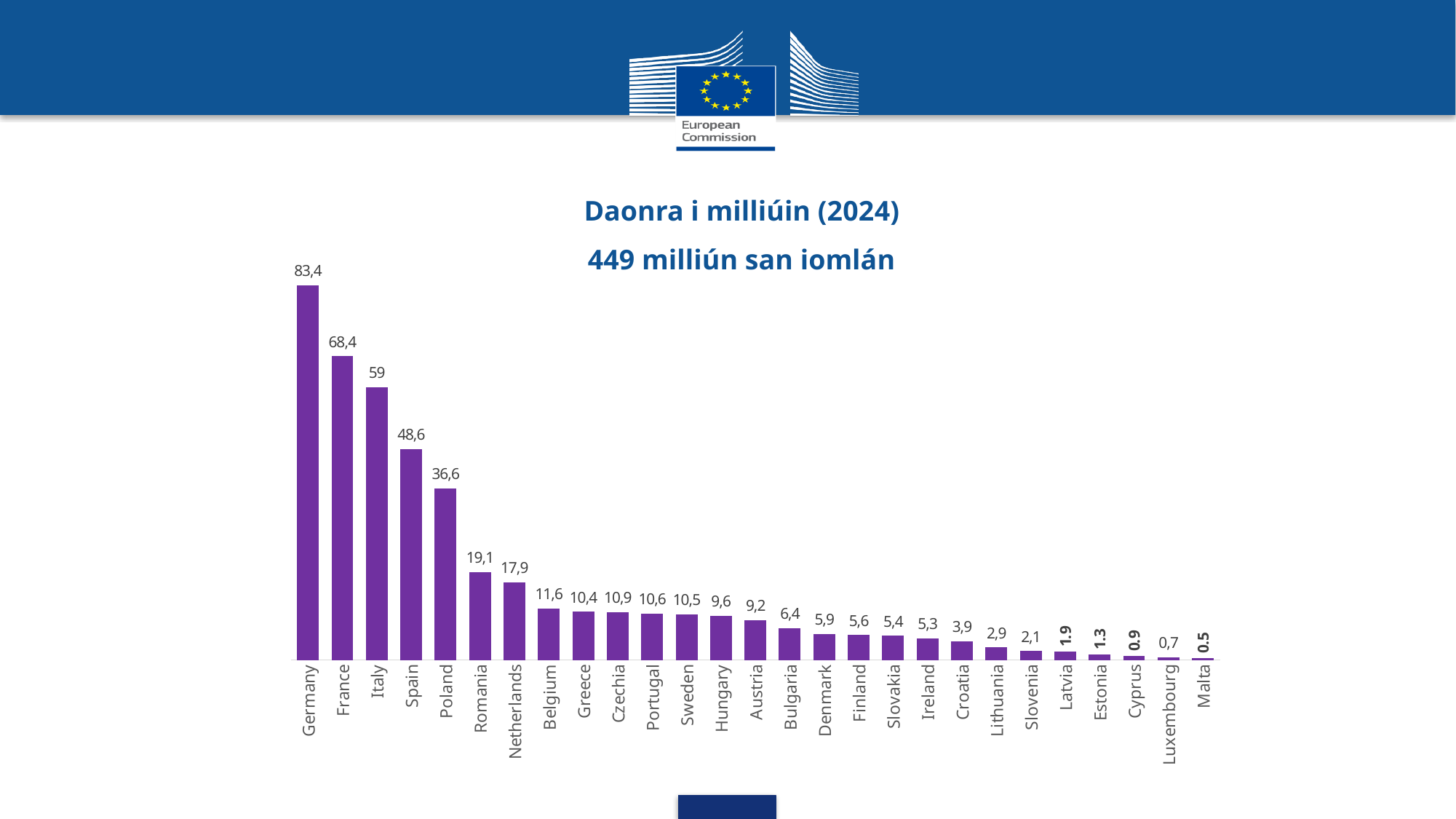
What kind of chart is shown on the slide? Bar chart What is the value shown for Germany? 83,4 What is the difference between the values for Germany and France? 15 What is the value shown for Netherlands? 17,9 What is the value shown for Luxembourg? 0,7 What is the value shown for Poland? 36,6 How many countries are shown in the chart? 27 Which country has the lowest value in the chart? Malta Which country has the highest value in the chart? Germany Which has the larger value, Greece or Czechia? Czechia Do the values rise or fall from left to right along the x axis? Fall What is the difference between the values for Spain and Poland? 12